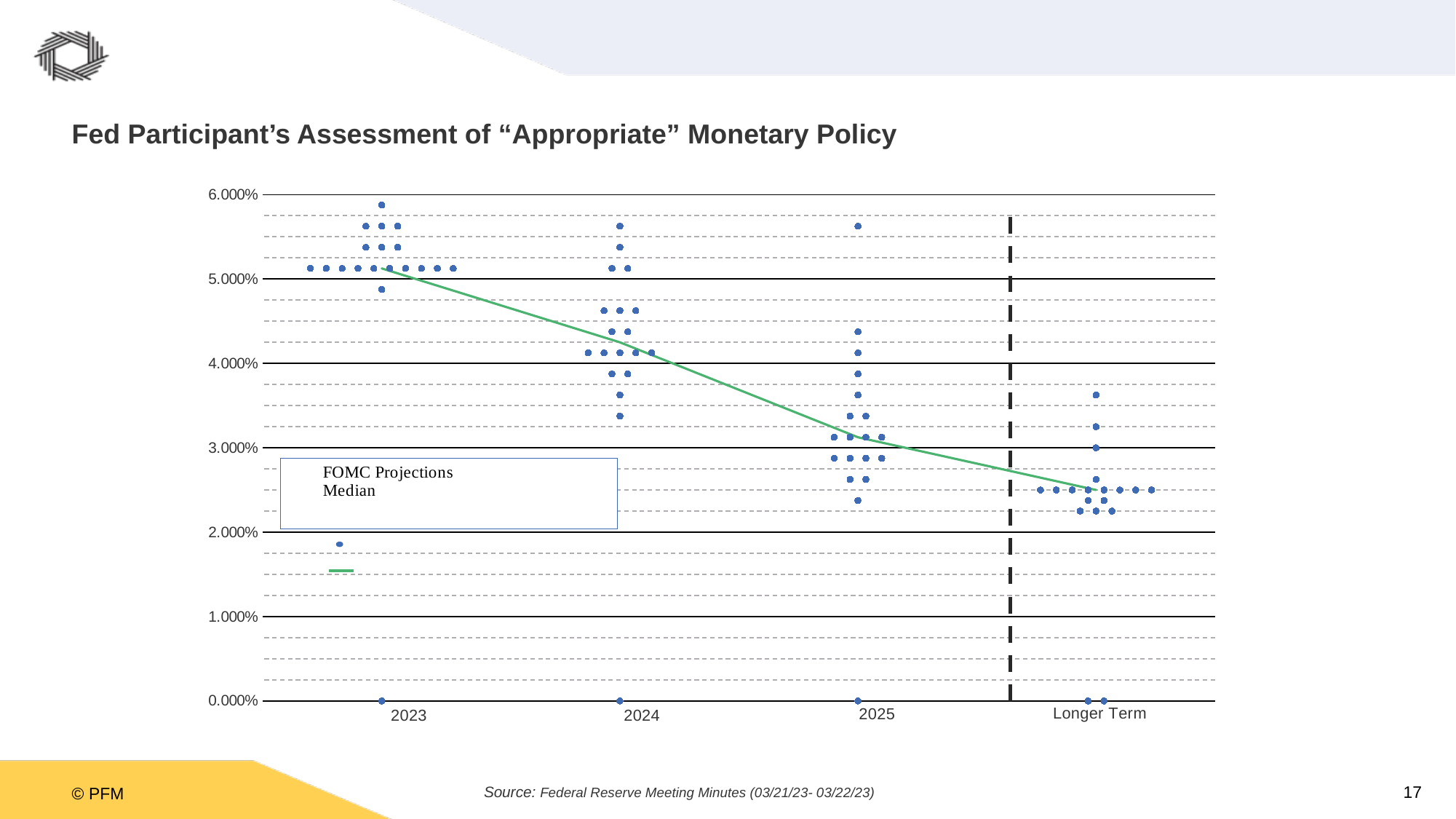
What kind of chart is shown on the slide? Dot plot (scatter chart) Is the Median value for 2024 greater or less than 4.000%? greater What are the two series named in the legend? FOMC Projections and Median How many categories are shown along the x axis? 4 Is the highest FOMC Projections dot for 2023 greater or less than 6.000%? less How many series does the legend list? 2 What is the title of the chart? Fed Participant's Assessment of "Appropriate" Monetary Policy Is the Median value for Longer Term greater or less than 3.000%? less Which category has the highest Median value? 2023 Does the Median line rise or fall from 2023 to Longer Term? Fall